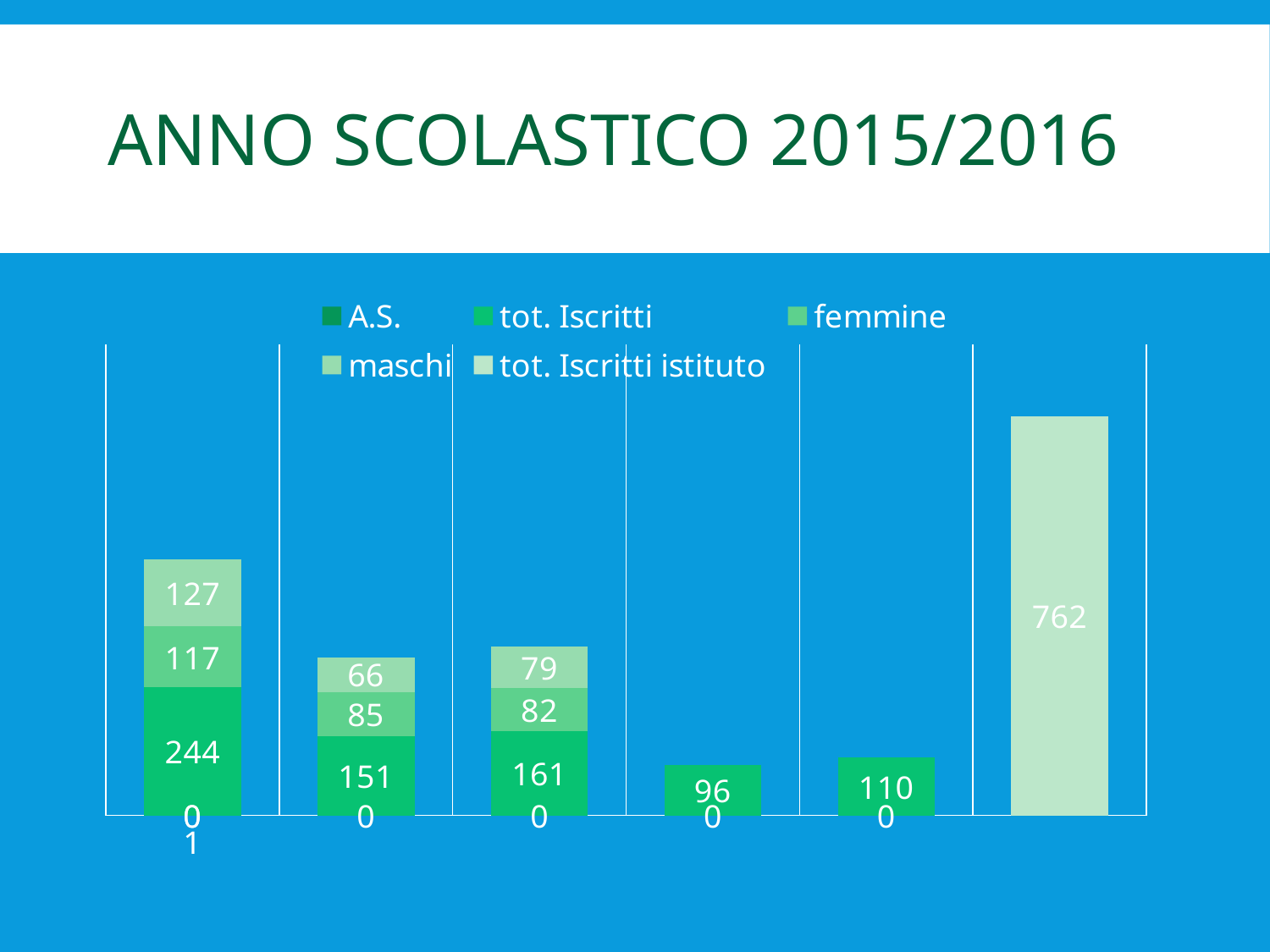
What kind of chart is shown on the slide? stacked bar chart How many bars are plotted in the chart? 6 Which is larger, the femmine value of the second bar or the femmine value of the third bar? second bar (85) How many series does the legend list? 5 What is the femmine value for the first bar? 117 Which bar has the highest single value in the chart? the last bar (762) What is the tot. Iscritti value for the first bar? 244 What is the total of the stacked values in the first bar (244 + 117 + 127)? 488 What is the maschi value for the second bar? 66 What is the tot. Iscritti value for the third bar? 161 What is the difference between the tot. Iscritti values of the third bar (161) and the second bar (151)? 10 What is the tot. Iscritti istituto value shown on the last bar? 762